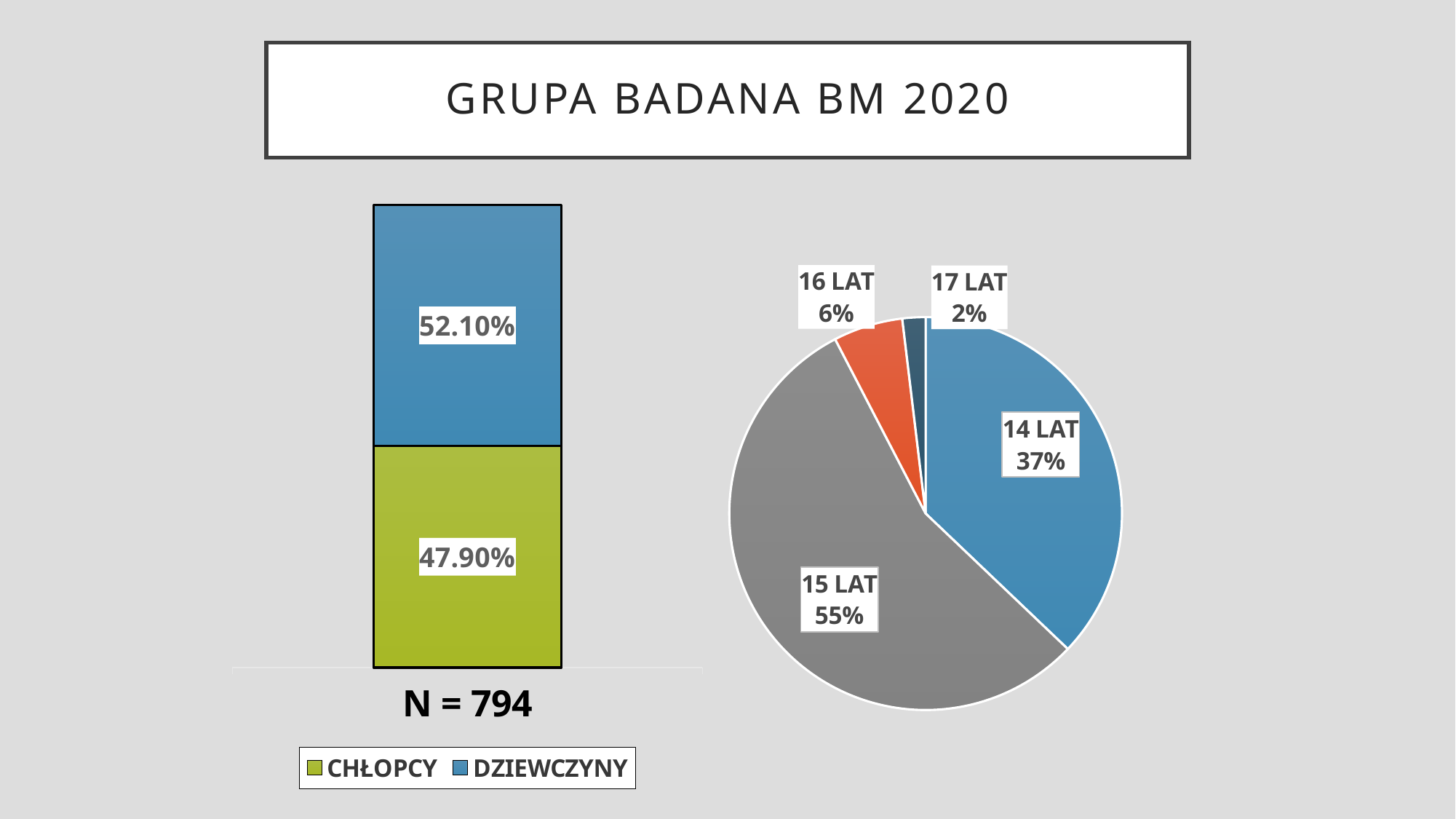
What sample size (N) is printed below the stacked bar chart on the left? N = 794 What kind of chart is shown on the right of the slide? Pie chart In the stacked bar chart on the left, what is the value for CHŁOPCY? 47.90% In the pie chart on the right, what is the value for 14 LAT? 37% In the stacked bar chart on the left, what is the value for DZIEWCZYNY? 52.10% In the stacked bar chart on the left, which series has the larger share, CHŁOPCY or DZIEWCZYNY? DZIEWCZYNY In the stacked bar chart on the left, what is the total of the two stacked segments? 100.00% In the pie chart on the right, what share does 15 LAT have? 55% How many slices does the pie chart on the right have? 4 In the pie chart on the right, which category has the smallest slice? 17 LAT In the stacked bar chart on the left, what is the difference between the DZIEWCZYNY and CHŁOPCY values? 4.20% How many series does the legend of the stacked bar chart on the left list? 2